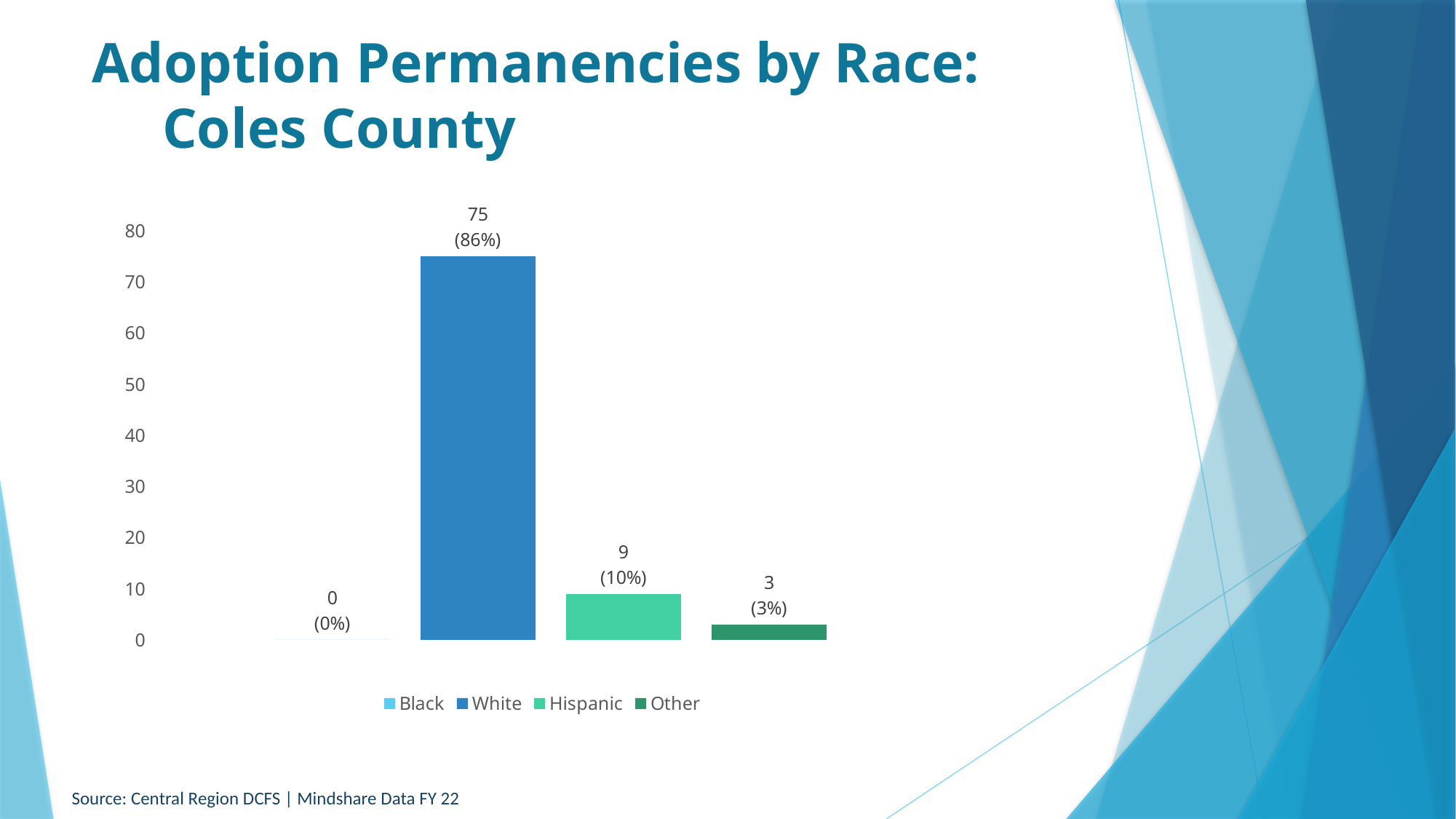
What is the number of adoption permanencies for Hispanic? 9 What kind of chart is shown on the slide? Bar chart Which race category has the lowest number of adoption permanencies? Black What is the difference between the White and Hispanic values? 66 What is the number of adoption permanencies for White? 75 Which race category has the highest number of adoption permanencies? White What is the title of the chart on the slide? Adoption Permanencies by Race: Coles County Which is larger, the value for Hispanic or the value for Other? Hispanic What is the number of adoption permanencies for Other? 3 Is the value for White greater or less than 70? greater What percentage of adoption permanencies is shown for Black? 0% How many race categories does the legend list? 4